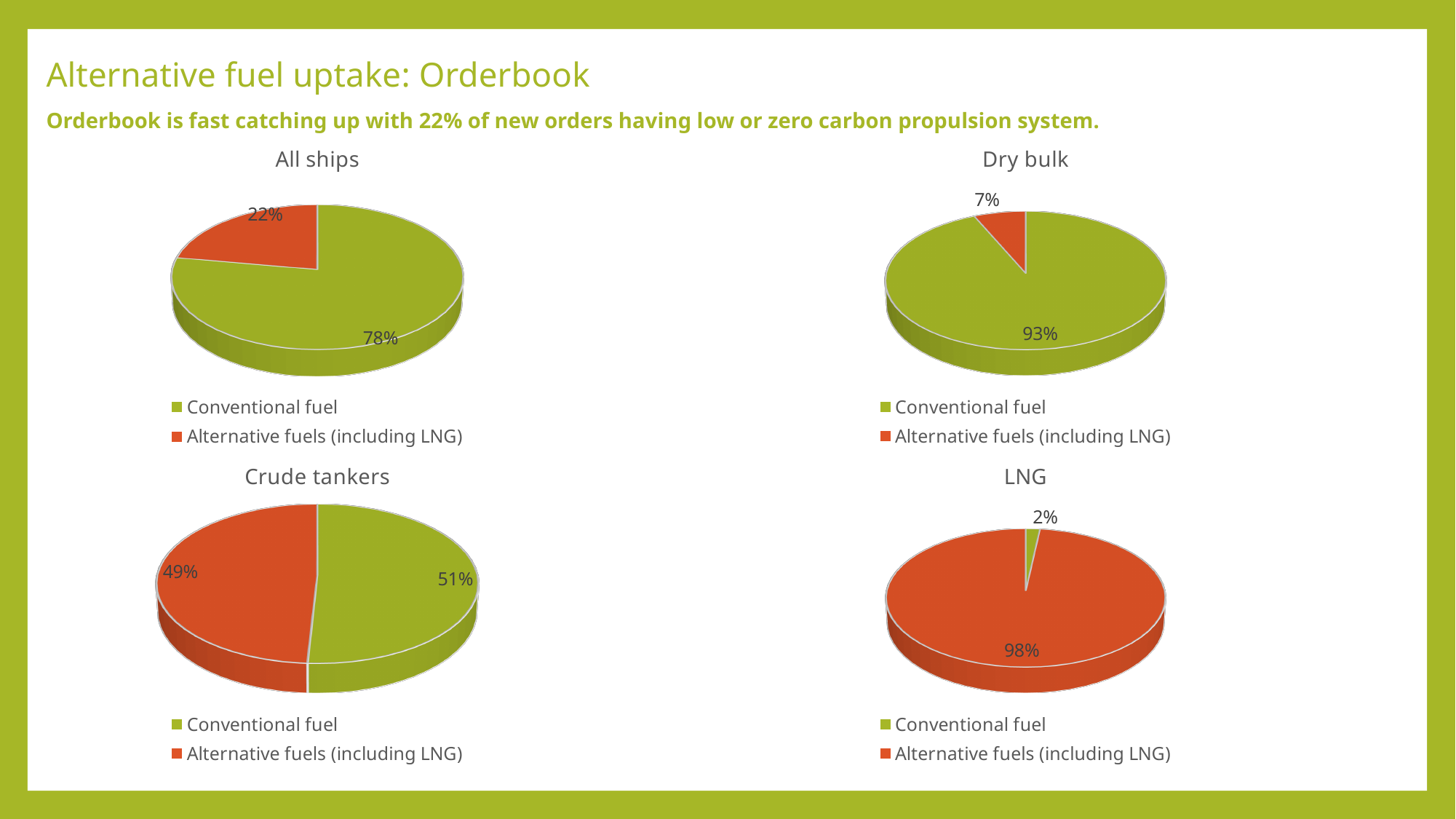
In the 'All ships' chart, what share of the pie is Alternative fuels (including LNG)? 22% In the 'LNG' chart, what share of the pie is Alternative fuels (including LNG)? 98% In the 'Dry bulk' chart, what share of the pie is Conventional fuel? 93% In the 'LNG' chart, which slice is larger, Conventional fuel or Alternative fuels (including LNG)? Alternative fuels (including LNG) In the 'Dry bulk' chart, what is the value for Alternative fuels (including LNG)? 7% How many entries does the legend of the 'All ships' chart list? 2 In the 'LNG' chart, what is the value for Conventional fuel? 2% What kind of chart is the 'Crude tankers' chart? Pie chart In the 'Crude tankers' chart, what is the value for Conventional fuel? 51% In the 'Crude tankers' chart, what is the value for Alternative fuels (including LNG)? 49% In the 'Dry bulk' chart, what is the difference between the Conventional fuel and Alternative fuels (including LNG) shares? 86% In the 'All ships' chart, what is the value for Conventional fuel? 78%